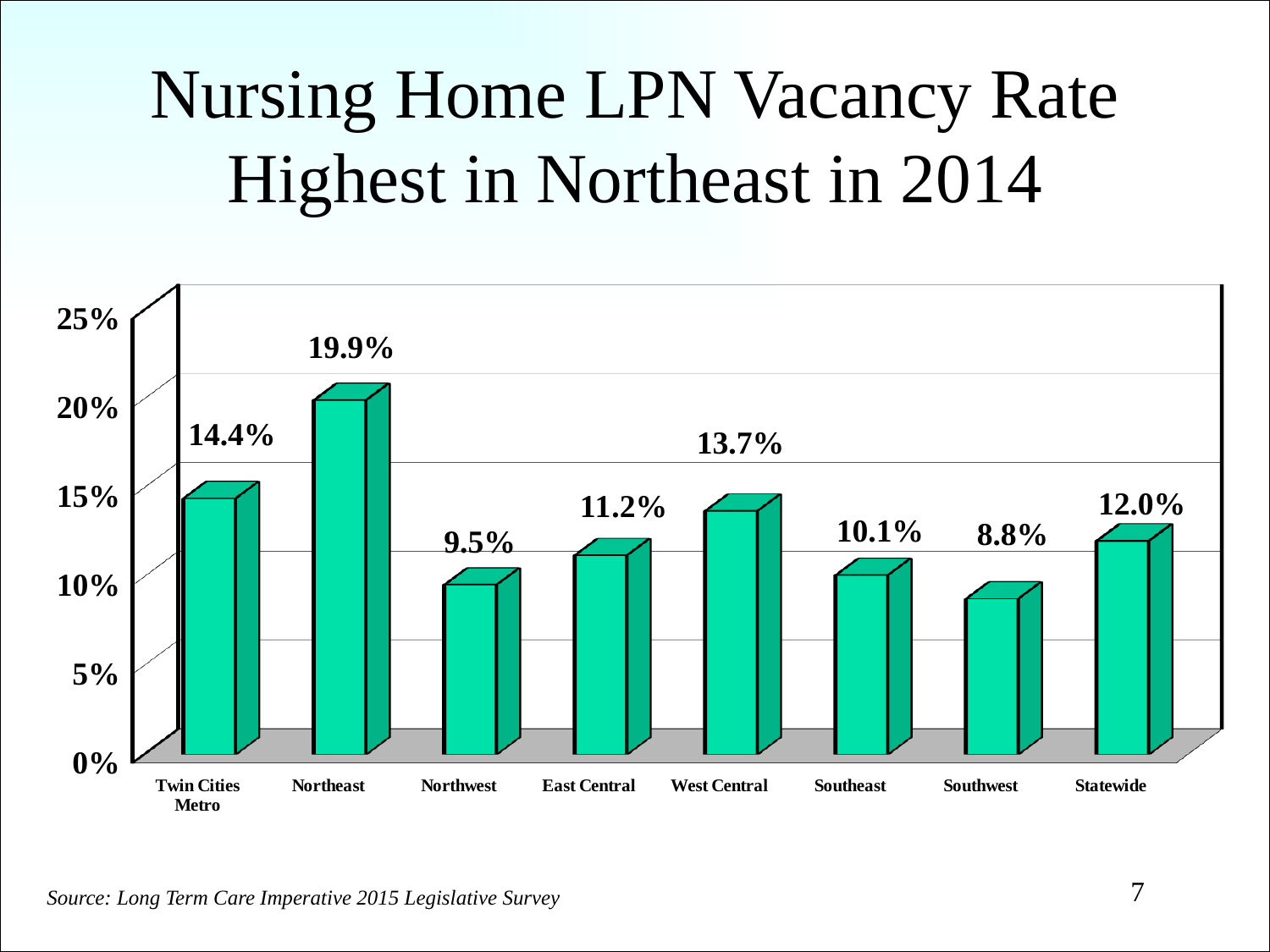
What is the difference between the West Central and East Central vacancy rates? 2.5% What is the LPN vacancy rate for Twin Cities Metro? 14.4% What is the Statewide LPN vacancy rate shown on the chart? 12.0% Is the vacancy rate for Twin Cities Metro greater or less than 15%? less What is the LPN vacancy rate for the Northeast region? 19.9% What is the difference between the Northeast and Southwest vacancy rates? 11.1% Which region has the lowest LPN vacancy rate? Southwest Which region has the highest LPN vacancy rate? Northeast Which has a higher vacancy rate, Southeast or Northwest? Southeast What is the source cited for the chart data? Long Term Care Imperative 2015 Legislative Survey What kind of chart is shown on the slide? bar chart How many regions (categories) are shown on the chart? 8